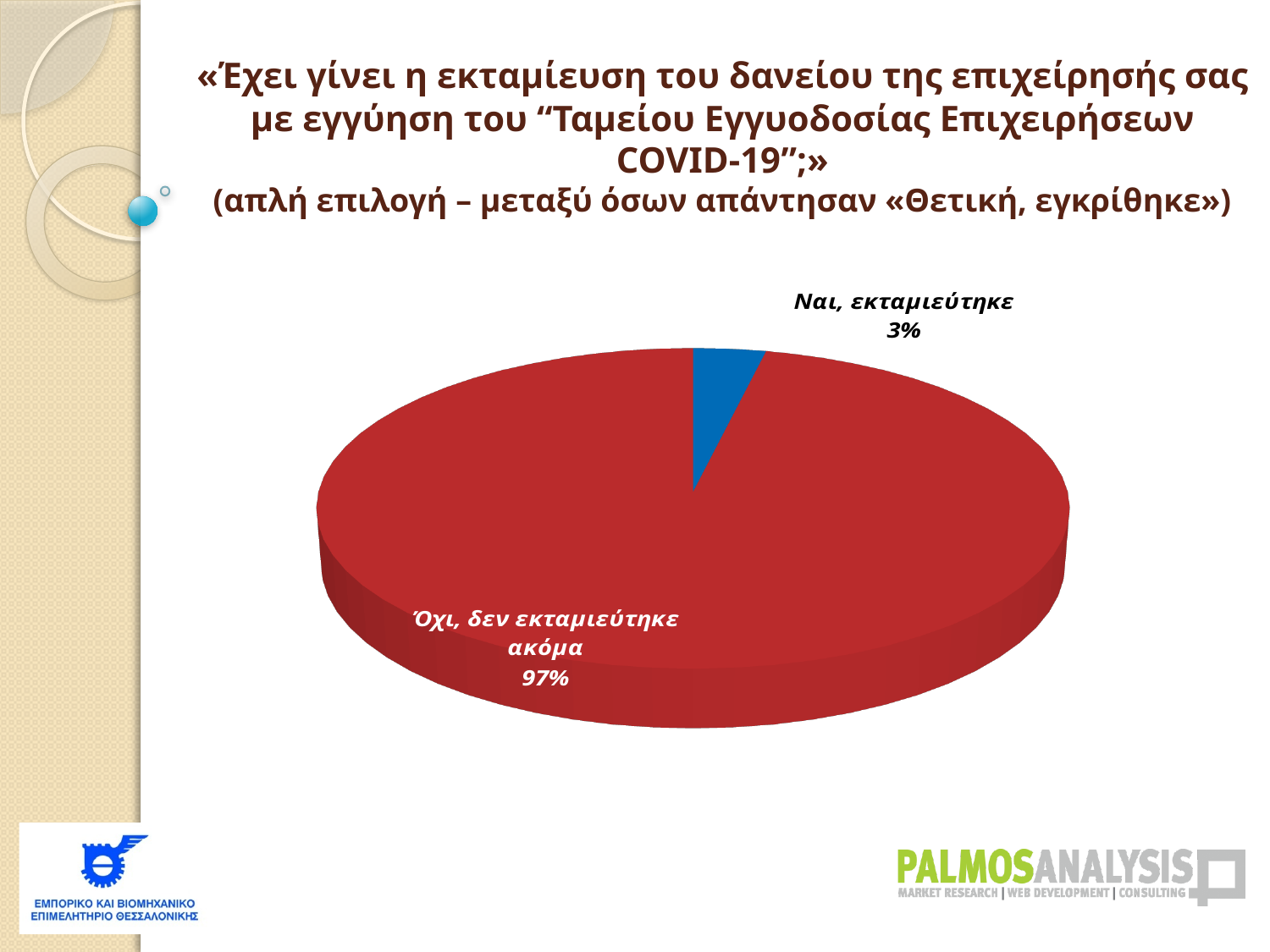
Which slice of the pie is the largest? Όχι, δεν εκταμιεύτηκε ακόμα What kind of chart is shown on the slide? Pie chart What is the total of the two percentages shown on the pie chart? 100% What share of the pie does "Ναι, εκταμιεύτηκε" represent? 3% What colour is the slice for "Όχι, δεν εκταμιεύτηκε ακόμα"? Red What share of the pie does "Όχι, δεν εκταμιεύτηκε ακόμα" represent? 97% Which slice of the pie is the smallest? Ναι, εκταμιεύτηκε What colour is the slice for "Ναι, εκταμιεύτηκε"? Blue How many slices does the pie chart have? 2 What is the difference in percentage points between "Όχι, δεν εκταμιεύτηκε ακόμα" and "Ναι, εκταμιεύτηκε"? 94 percentage points Which is larger: the share for "Ναι, εκταμιεύτηκε" or the share for "Όχι, δεν εκταμιεύτηκε ακόμα"? Όχι, δεν εκταμιεύτηκε ακόμα